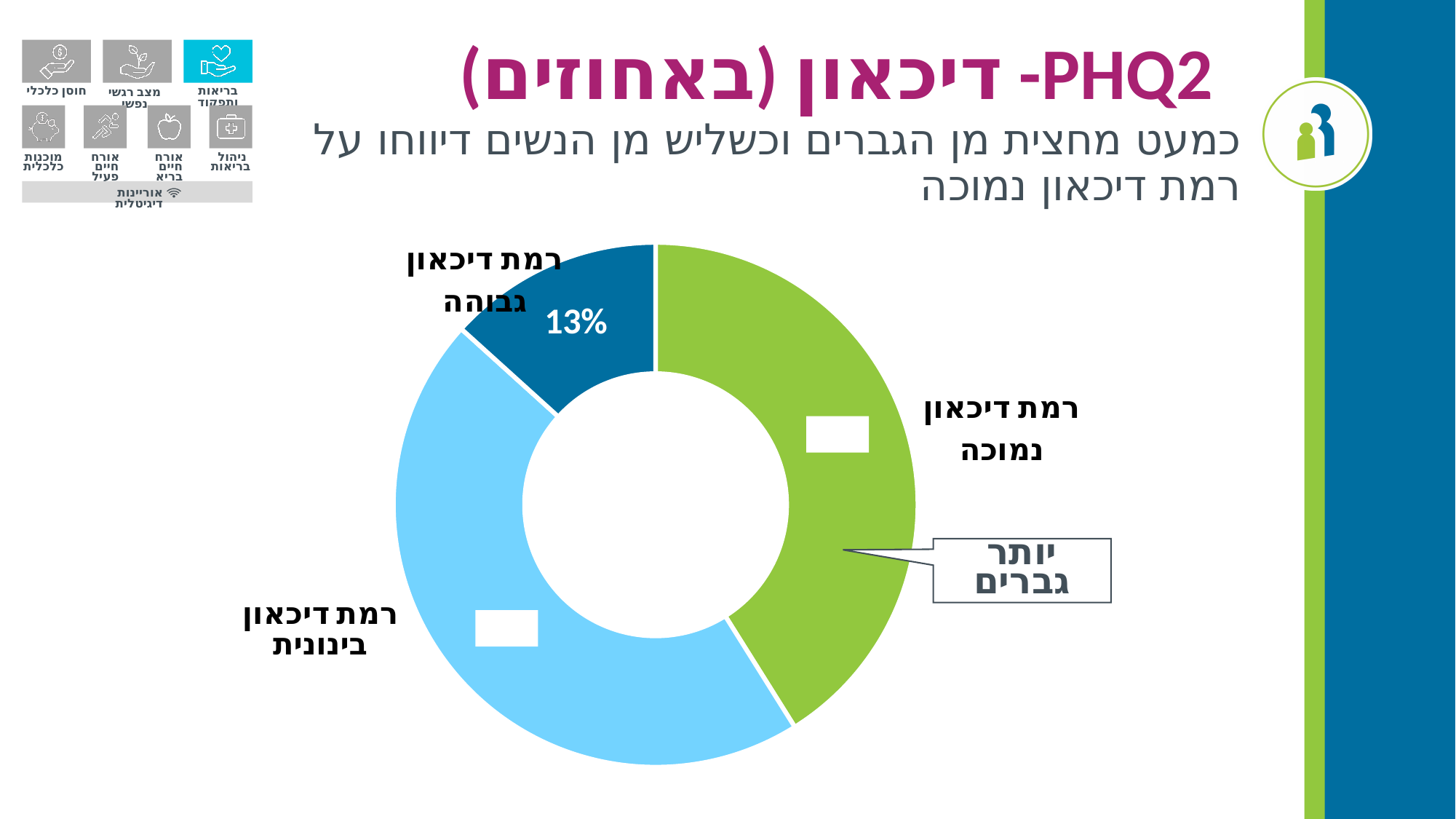
What share of the chart does the 'רמת דיכאון גבוהה' slice represent? 13% Which category has the smallest slice in the chart? רמת דיכאון גבוהה Which slice does the callout 'יותר גברים' (more men) point to? רמת דיכאון נמוכה How many categories (slices) does the chart have? 3 Which slice is larger: 'רמת דיכאון בינונית' or 'רמת דיכאון גבוהה'? רמת דיכאון בינונית What colour is the 'רמת דיכאון נמוכה' slice? Green What percentage is shown for the slice 'רמת דיכאון גבוהה' (high depression level)? 13% What kind of chart is shown on the slide? Donut (pie) chart Which slice is larger: 'רמת דיכאון נמוכה' or 'רמת דיכאון גבוהה'? רמת דיכאון נמוכה